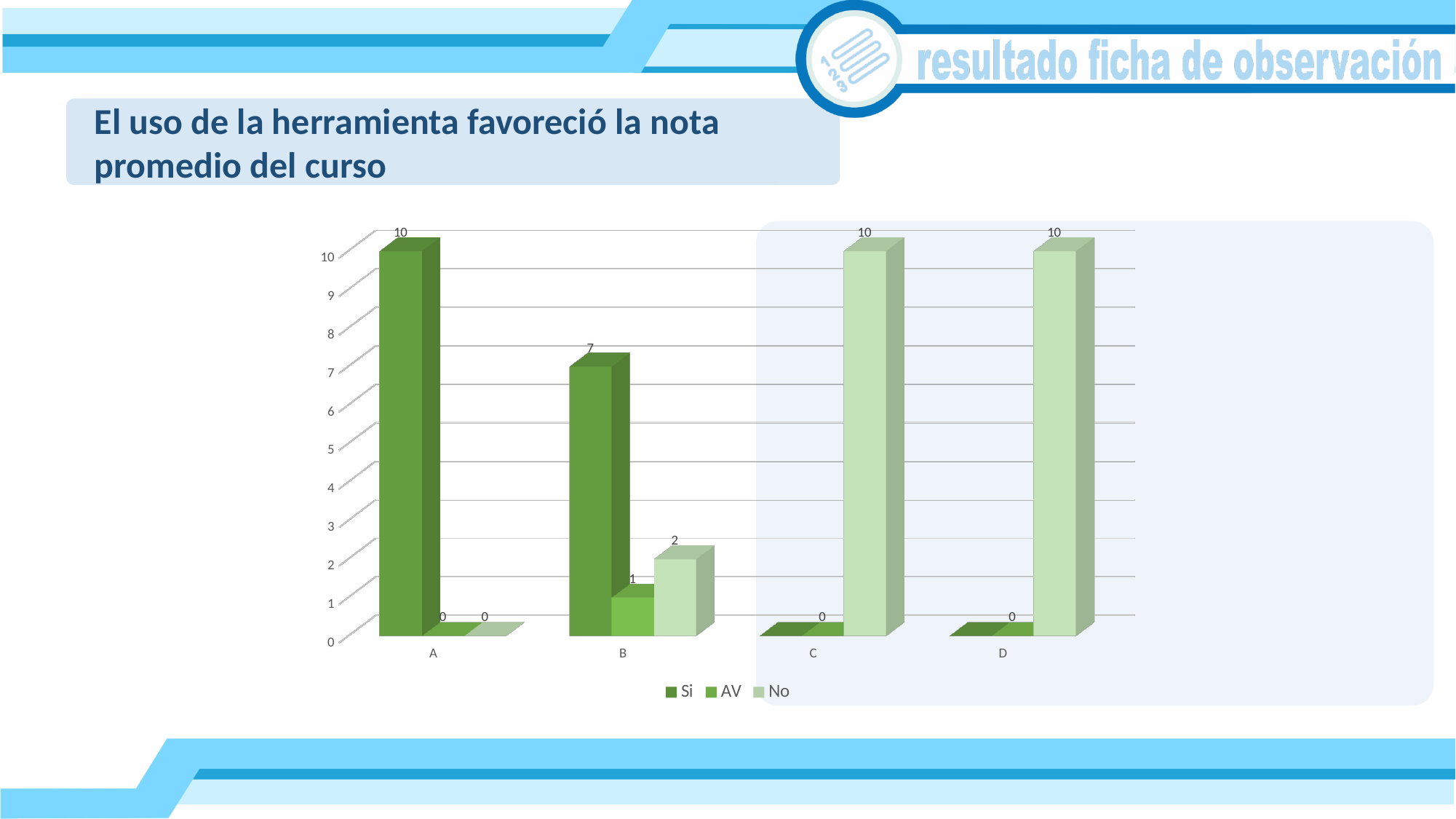
What is the value of the Si series for category B? 7 What is the value of the No series for category D? 10 What is the value of the No series for category B? 2 How many categories are shown on the x axis? 4 What is the value of the Si series for category A? 10 Which category has the highest value for the Si series? A What is the value of the AV series for category B? 1 What is the value of the No series for category C? 10 How many series does the legend list? 3 For category B, which is larger: the No value or the AV value? No What is the difference between the Si values for categories A and B? 3 What kind of chart is shown on the slide? Bar chart